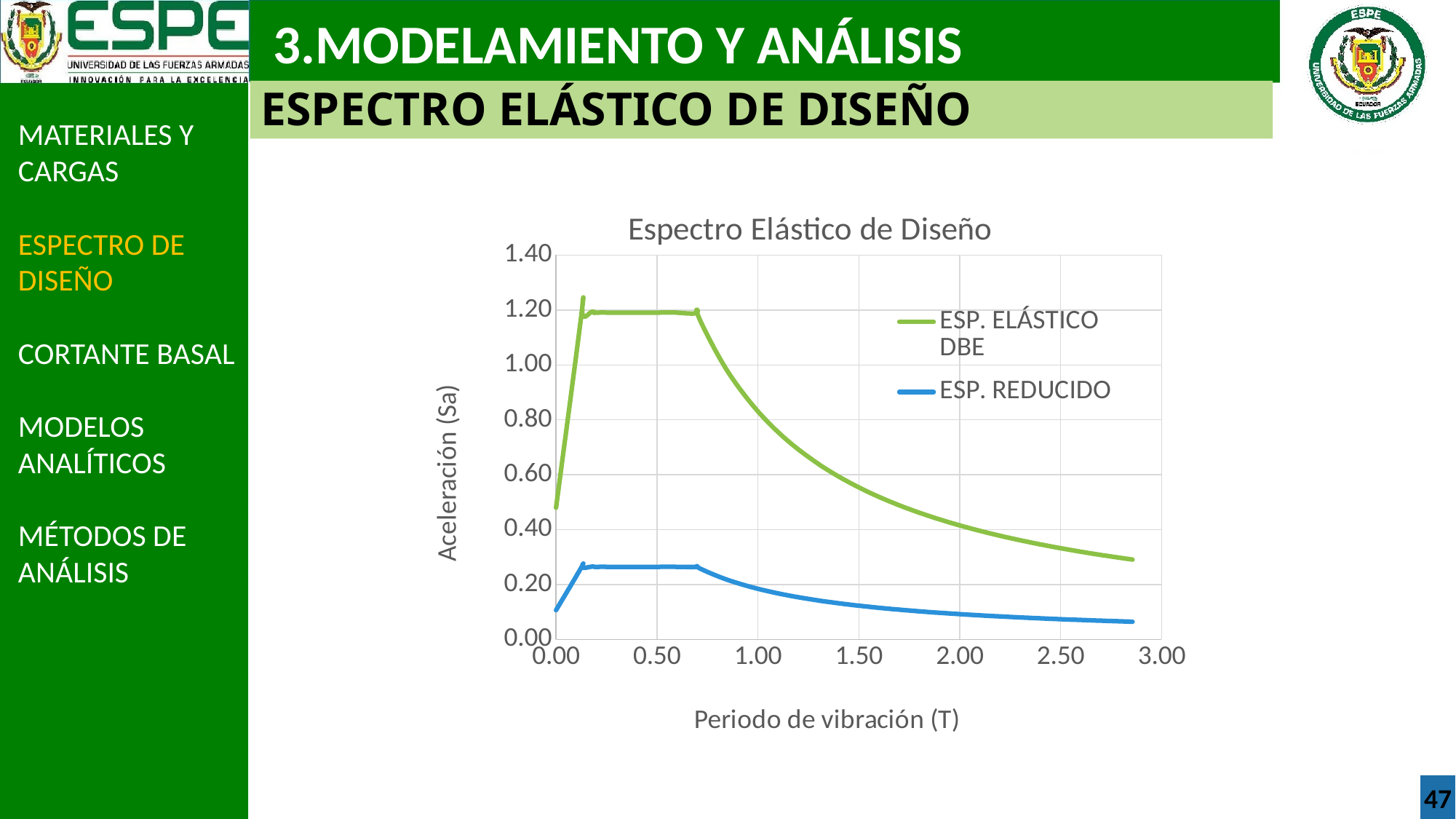
Is the value of ESP. REDUCIDO at a period of 2.00 greater or less than 0.20? less Is the value of ESP. REDUCIDO at a period of 0.50 greater or less than 0.40? less How many series does the legend list? 2 Is the value of ESP. ELÁSTICO DBE at a period of 2.00 greater or less than 0.60? less What is the title of the chart? Espectro Elástico de Diseño What kind of chart is shown on the slide? line chart Between periods of 1.00 and 2.50, does the ESP. ELÁSTICO DBE series rise or fall? fall Which series has the higher value at a period of 1.00, ESP. ELÁSTICO DBE or ESP. REDUCIDO? ESP. ELÁSTICO DBE What is the label of the x axis? Periodo de vibración (T)